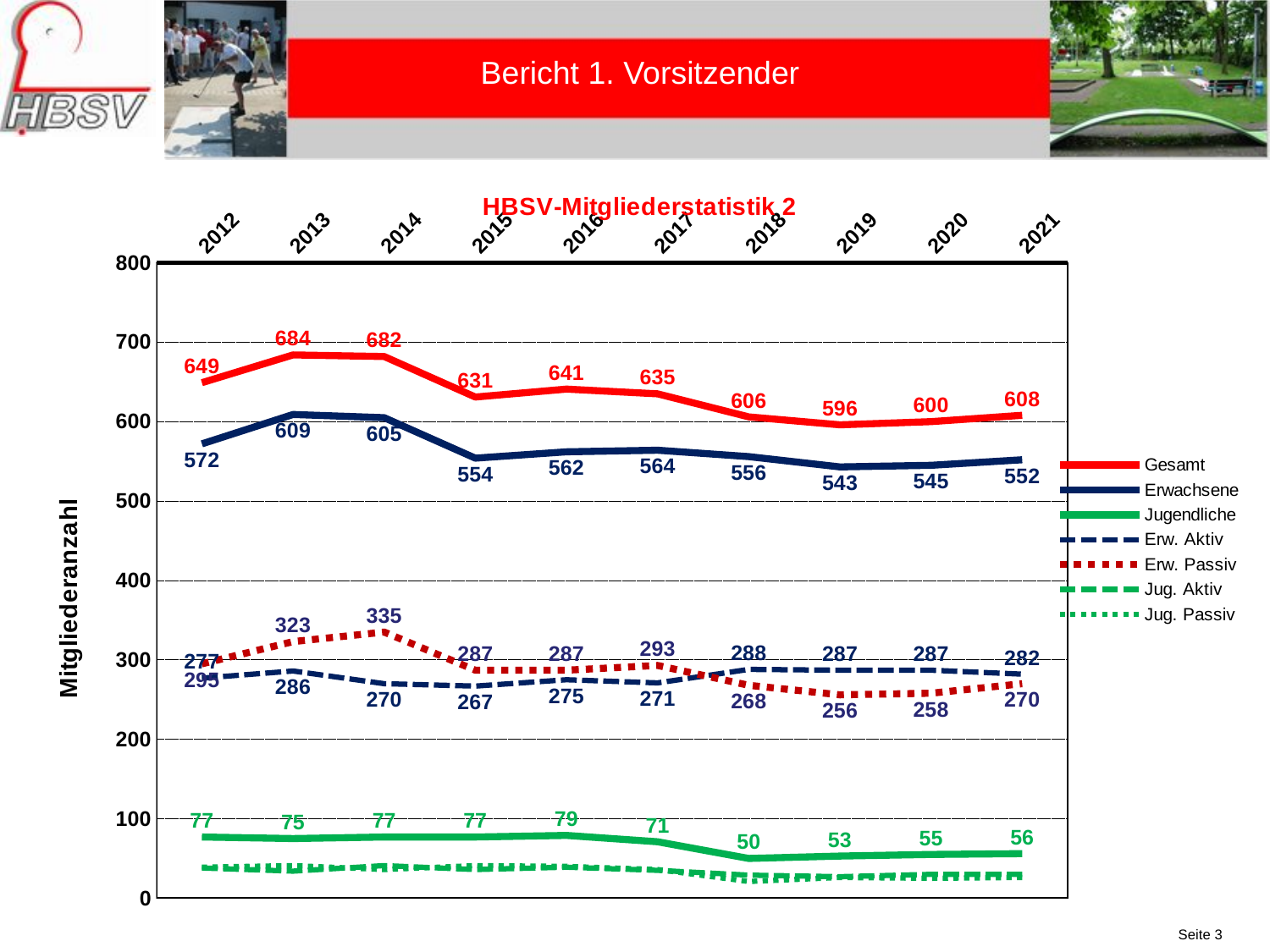
What is the Jugendliche value for 2018? 50 What is the label of the y axis? Mitgliederanzahl What is the Erwachsene value for 2021? 552 What is the Gesamt value for 2012? 649 In which year is the Gesamt value lowest? 2019 How many years are plotted along the x axis? 10 Is the Jug. Aktiv value for 2012 greater or less than 100? less What kind of chart is shown on the slide? line chart Which year has the larger Jugendliche value, 2016 or 2017? 2016 In which year is the Gesamt value highest? 2013 How many series does the legend of the HBSV-Mitgliederstatistik 2 chart list? 7 By how much did the Gesamt value change from 2012 to 2013? 35